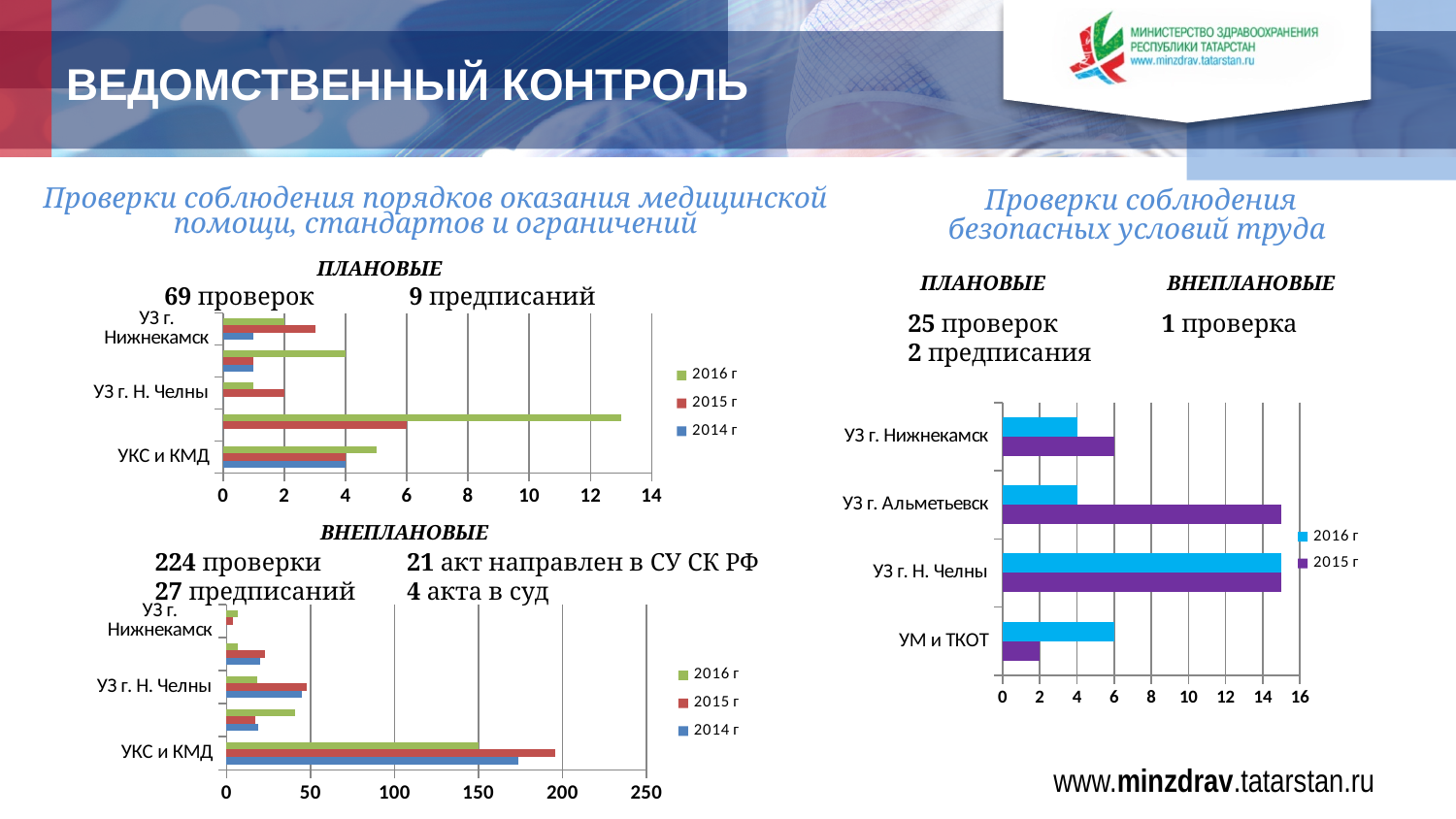
In the bottom-left chart titled 'ВНЕПЛАНОВЫЕ', is the 2015 г value for УКС и КМД greater or less than 150? greater In the bottom-left chart titled 'ВНЕПЛАНОВЫЕ', which labelled category has the highest values? УКС и КМД In the chart on the right, how many categories are shown on the vertical axis? 4 In the chart on the right, which is larger for УЗ г. Альметьевск, the 2015 г value or the 2016 г value? 2015 г In the top-left chart titled 'ПЛАНОВЫЕ', how many series does the legend list? 3 In the chart on the right, what is the 2015 г value for УЗ г. Нижнекамск? 6 In the chart on the right, is the 2015 г value for УЗ г. Альметьевск greater or less than 10? greater In the chart on the right, how many series does the legend list? 2 In the chart on the right, which category has the highest 2016 г value? УЗ г. Н. Челны What kind of chart is the chart on the right under 'Проверки соблюдения безопасных условий труда'? bar chart In the chart on the right, which category has the lowest 2015 г value? УМ и ТКОТ In the chart on the right, what is the 2016 г value for УМ и ТКОТ? 6